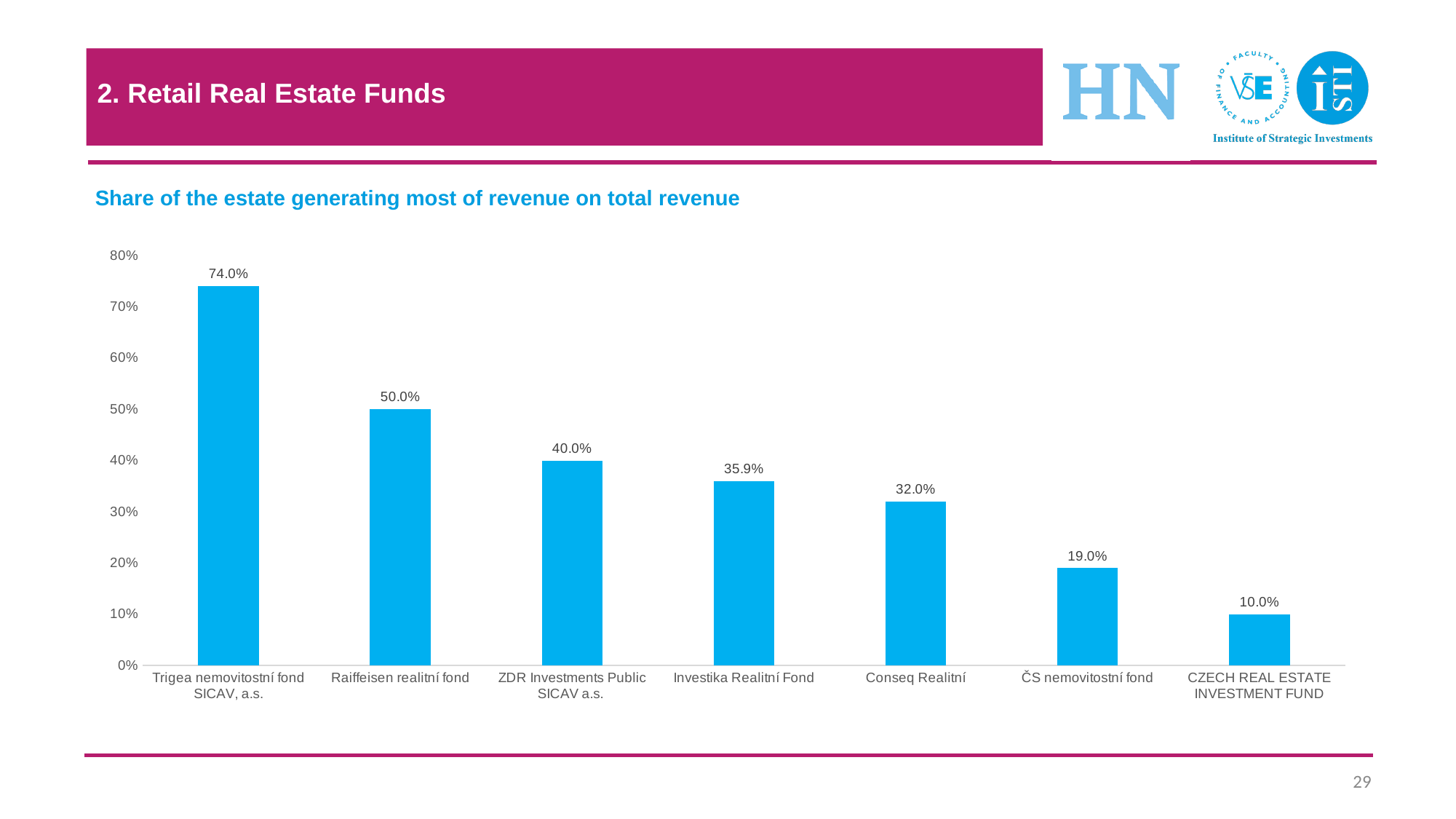
What is the title of the chart? Share of the estate generating most of revenue on total revenue Which is larger, the value for Conseq Realitní or the value for Investika Realitní Fond? Investika Realitní Fond What is the value for ČS nemovitostní fond? 19.0% Which fund has the lowest share? CZECH REAL ESTATE INVESTMENT FUND What is the value for Investika Realitní Fond? 35.9% Do the values rise or fall from left to right along the x axis? Fall Is the value for Conseq Realitní greater or less than 30%? greater What is the difference between the values for Raiffeisen realitní fond and ZDR Investments Public SICAV a.s.? 10.0% What is the value for Trigea nemovitostní fond SICAV, a.s.? 74.0% What kind of chart is shown on the slide? Bar chart Which fund has the highest share? Trigea nemovitostní fond SICAV, a.s. How many funds are shown in the chart? 7